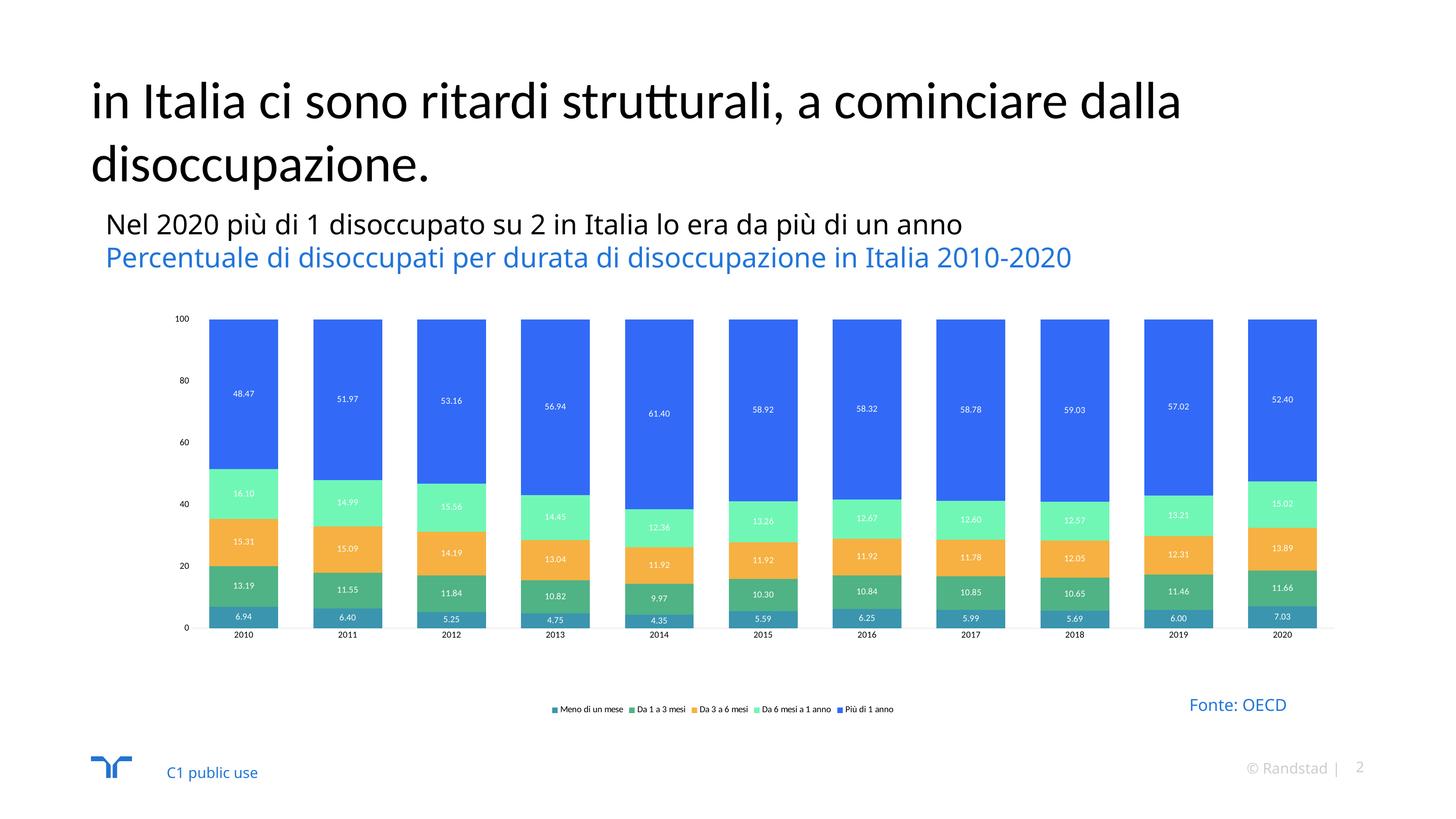
What is the difference between the "Più di 1 anno" values for 2014 and 2010? 12.93 In which year is the "Meno di un mese" value lowest? 2014 Which is larger, the "Da 1 a 3 mesi" value in 2010 or in 2020? 2010 In which year is the "Più di 1 anno" value highest? 2014 What kind of chart is shown on the slide? Stacked bar chart What is the value for "Da 6 mesi a 1 anno" in 2013? 14.45 What is the value for "Più di 1 anno" in 2014? 61.40 What is the value for "Meno di un mese" in 2020? 7.03 What is the value for "Da 3 a 6 mesi" in 2010? 15.31 How many years are shown on the x axis? 11 In which year is the "Più di 1 anno" value lowest? 2010 How many series does the legend list? 5